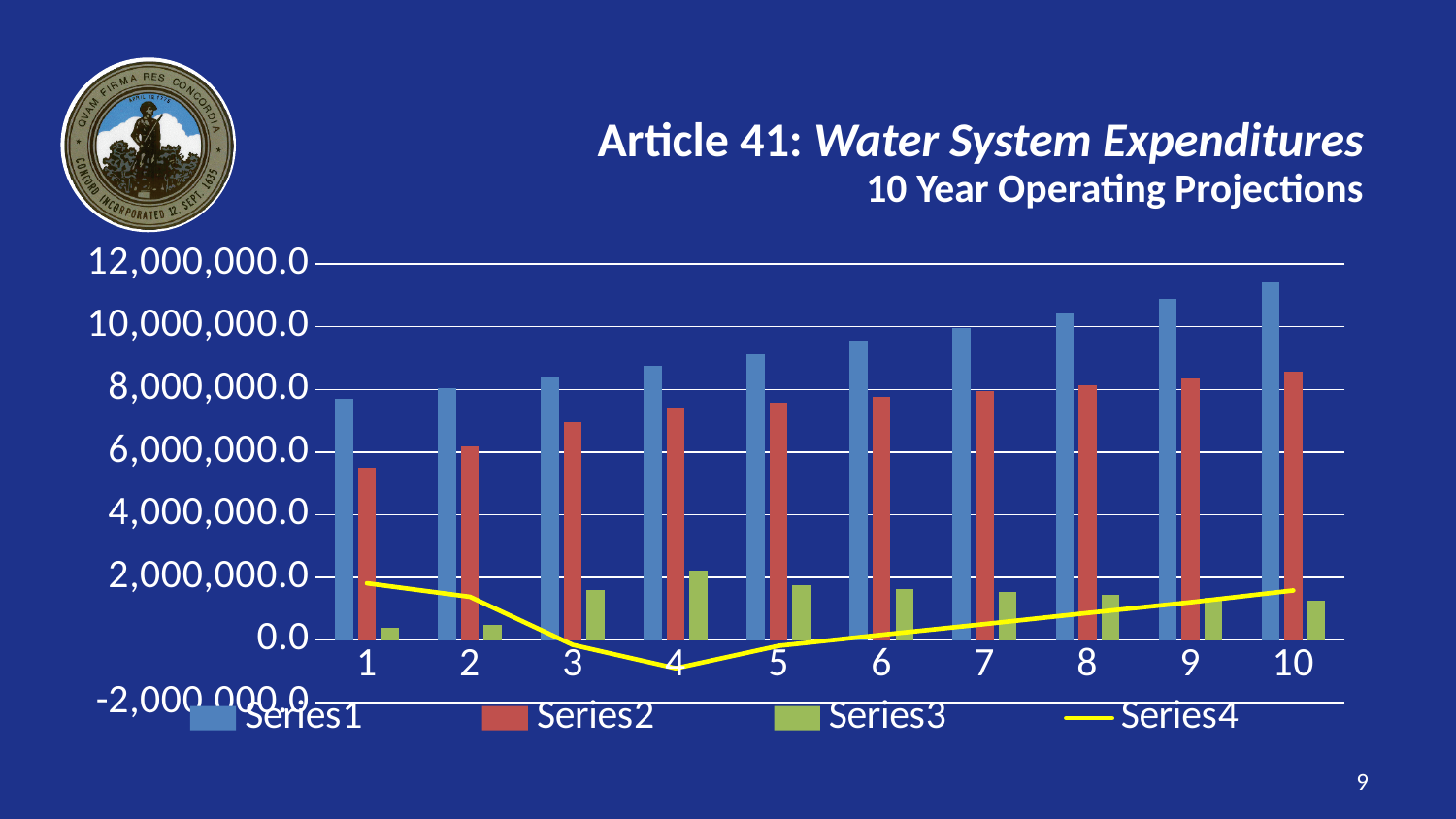
For which category is Series3 highest? 4 For which category is Series1 lowest? 1 Is the value for Series1 at category 10 greater or less than 10,000,000.0? greater For which category is Series1 highest? 10 Do the Series1 values rise or fall from category 1 to category 10? rise At category 5, which is larger, Series1 or Series2? Series1 For which category is Series2 highest? 10 How many series does the legend list? 4 For which category does the Series4 line reach its lowest point? 4 Is the value for Series4 at category 4 greater or less than 0.0? less What kind of chart is shown on the slide? bar chart with a line How many categories are shown along the x axis? 10